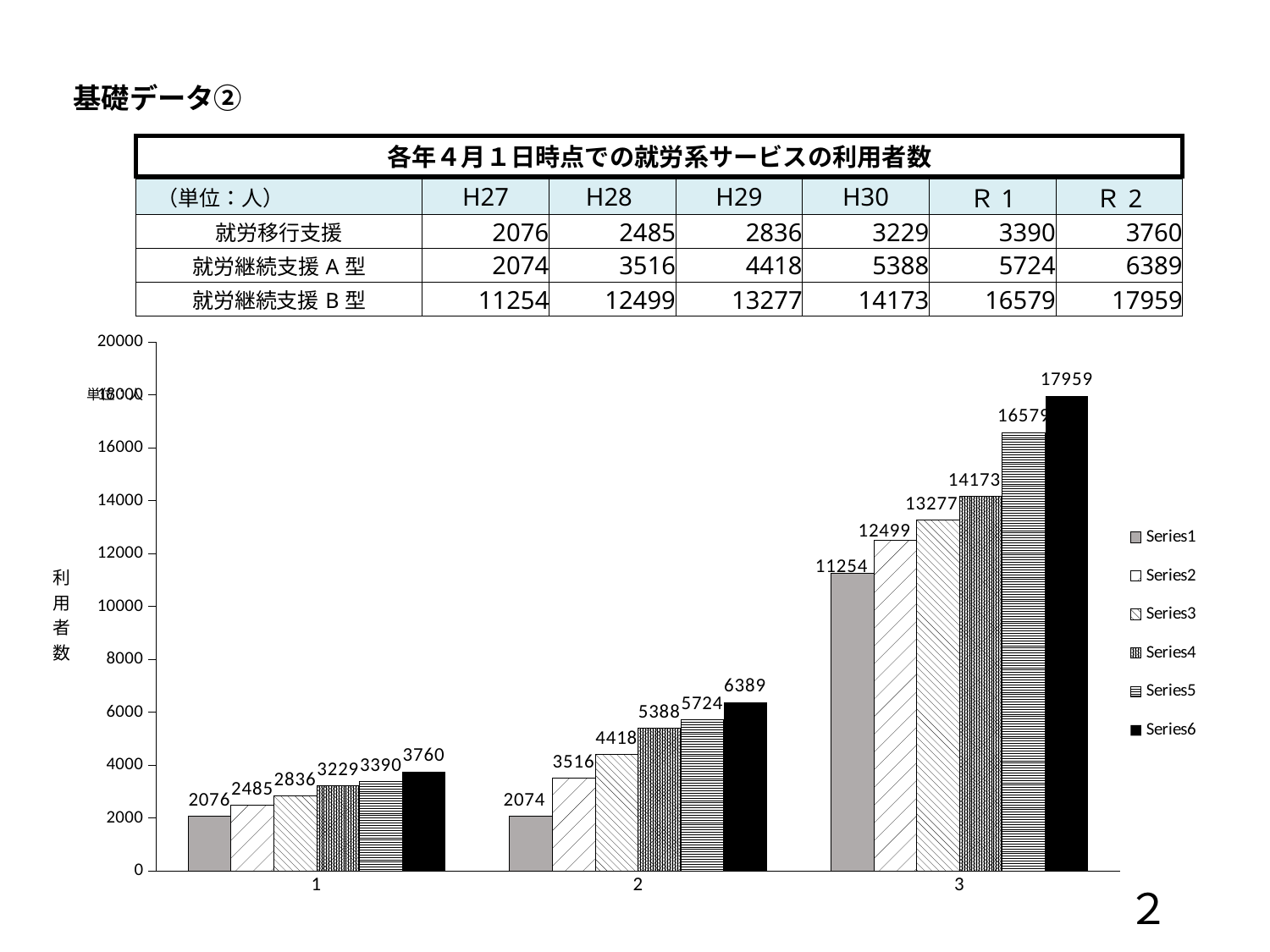
How many series does the legend list? 6 Which is larger: Series2 for category 2 or Series6 for category 1? Series6 for category 1 What is the value of Series6 for category 3? 17959 Which series has the lowest value for category 1? Series1 What is the difference between Series5 and Series4 for category 2? 336 Is the value of Series5 for category 3 greater or less than 16000? greater How many categories are shown on the x axis? 3 What is the value of Series1 for category 2? 2074 What kind of chart is shown on the slide? bar chart Which series has the highest value for category 3? Series6 What is the difference between Series6 and Series1 for category 3? 6705 What is the value of Series3 for category 1? 2836